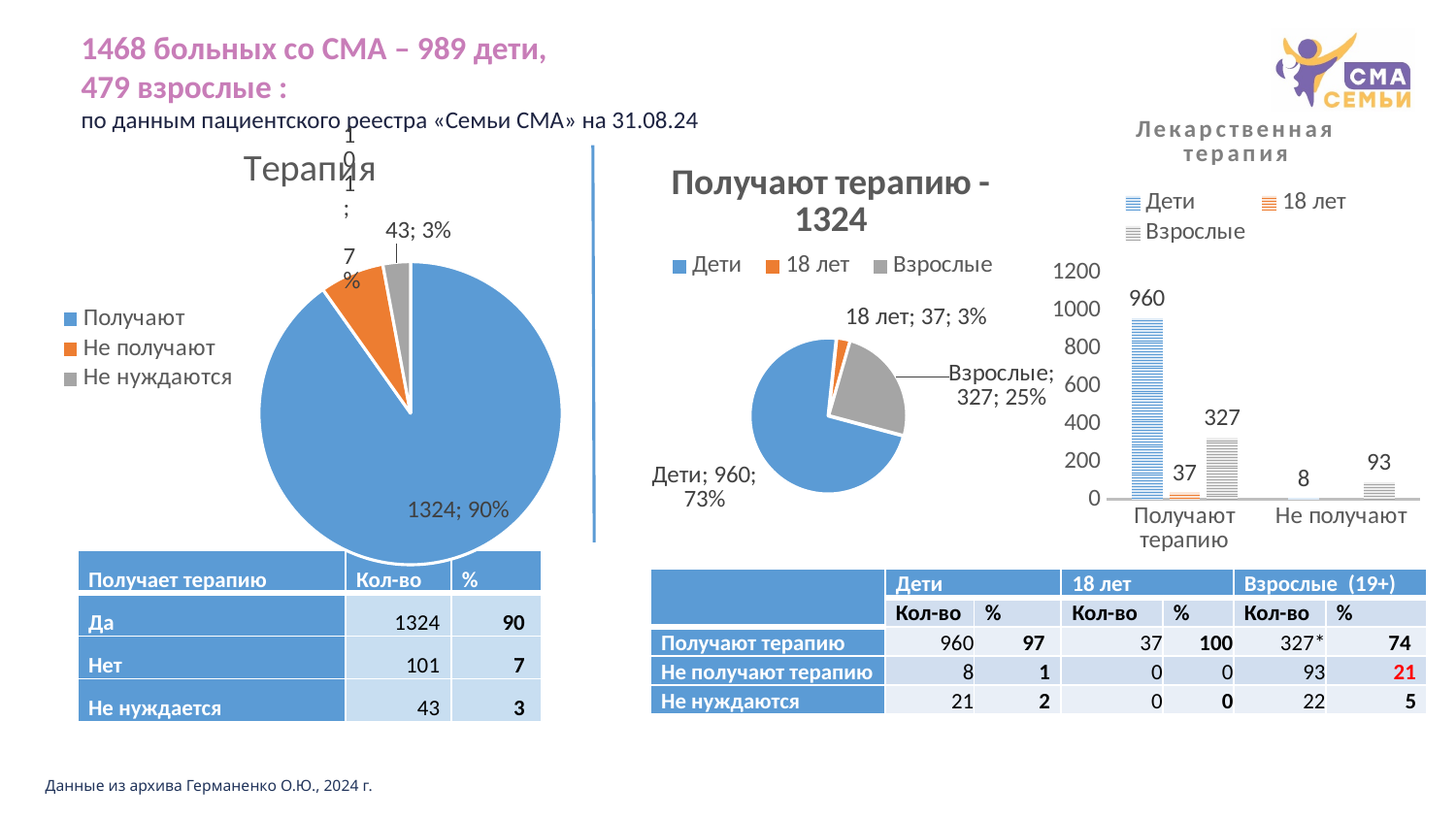
In the bar chart titled "Лекарственная терапия", how many series does the legend list? 3 In the bar chart titled "Лекарственная терапия", is the value for "Дети" in the "Получают терапию" category greater or less than 800? greater In the pie chart titled "Терапия", how many slices does the legend list? 3 In the bar chart titled "Лекарственная терапия", what is the value for "Взрослые" in the "Не получают" category? 93 In the bar chart titled "Лекарственная терапия", which is larger in the "Получают терапию" category: "18 лет" or "Взрослые"? Взрослые In the pie chart titled "Получают терапию - 1324", what value is shown for "Взрослые"? 327; 25% In the pie chart titled "Получают терапию - 1324", which slice is the largest? Дети In the pie chart titled "Получают терапию - 1324", which slice is the smallest? 18 лет What kind of chart is the chart titled "Лекарственная терапия"? bar chart In the pie chart titled "Терапия", what share of the pie does the "Не нуждаются" slice represent? 3% In the pie chart titled "Получают терапию - 1324", what is the difference between the "Дети" count and the "Взрослые" count? 633 In the pie chart titled "Терапия", what value is shown for the "Получают" slice? 1324; 90%